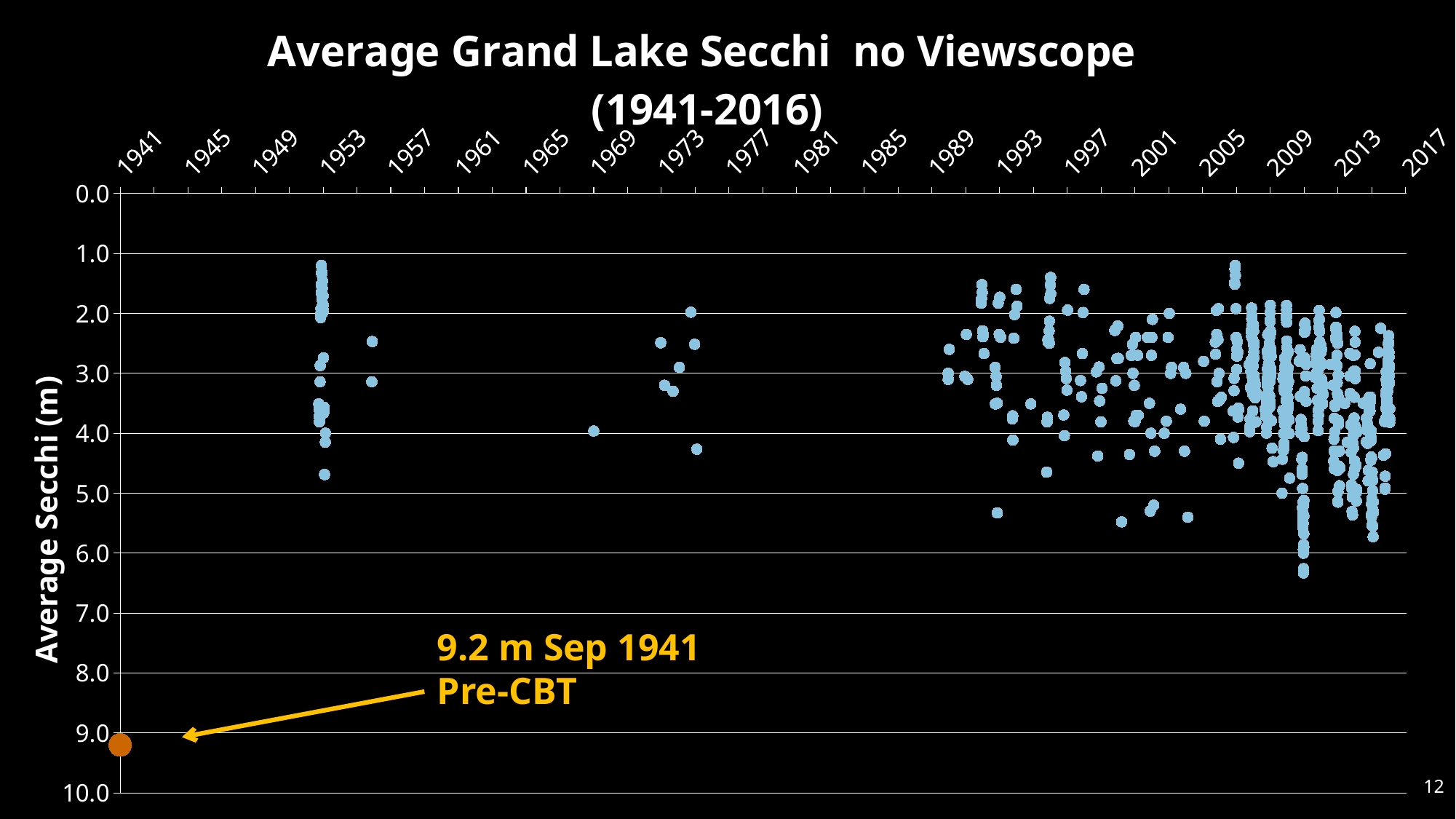
Is the value of the orange 1941 point greater or less than 9.0? greater Is the 1941 orange point deeper than every blue point on the chart? Yes What is the Secchi depth of the annotated orange point from September 1941? 9.2 m What is the label on the vertical axis? Average Secchi (m) Which point on the chart has the greatest Secchi depth? The orange 1941 point (9.2 m) Is the shallowest blue reading around 1952 greater or less than 2.0? less In which year was the annotated Pre-CBT Secchi reading taken? 1941 What kind of chart is shown on the slide? scatter chart What is the title of the chart? Average Grand Lake Secchi no Viewscope (1941-2016) Is the deepest blue reading around 2009 greater or less than 6.0? greater